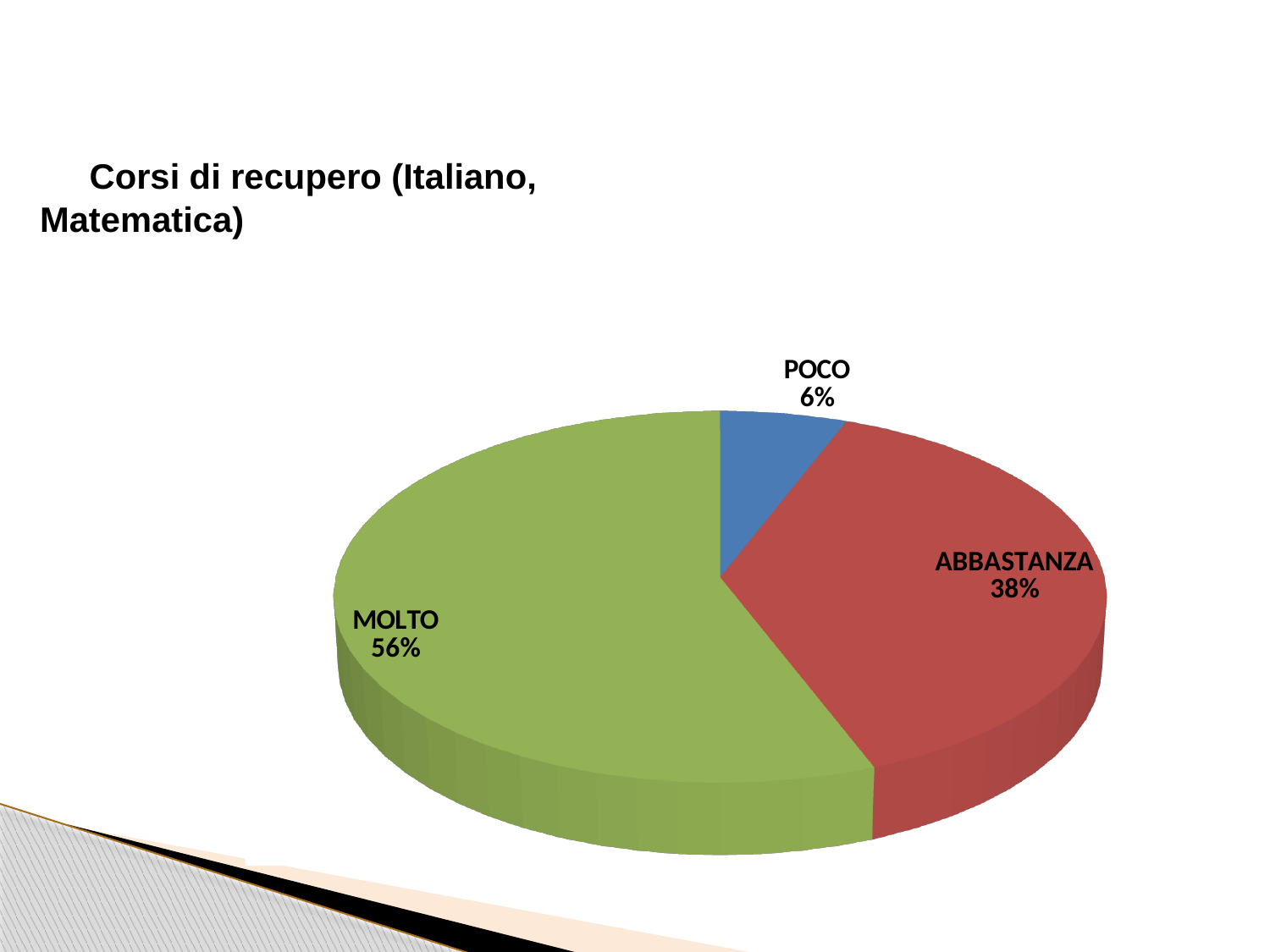
What is the title shown above the chart? Corsi di recupero (Italiano, Matematica) What percentage of the pie is labelled MOLTO? 56% What is the difference in percentage points between ABBASTANZA and POCO? 32 What percentage of the pie is labelled POCO? 6% Which is larger, the share for ABBASTANZA or the share for POCO? ABBASTANZA Which category has the smallest share of the pie? POCO What kind of chart is shown on the slide? Pie chart How many slices does the pie chart have? 3 Which category has the largest share of the pie? MOLTO What is the difference in percentage points between MOLTO and ABBASTANZA? 18 What percentage of the pie is labelled ABBASTANZA? 38% What colour is the MOLTO slice? Green